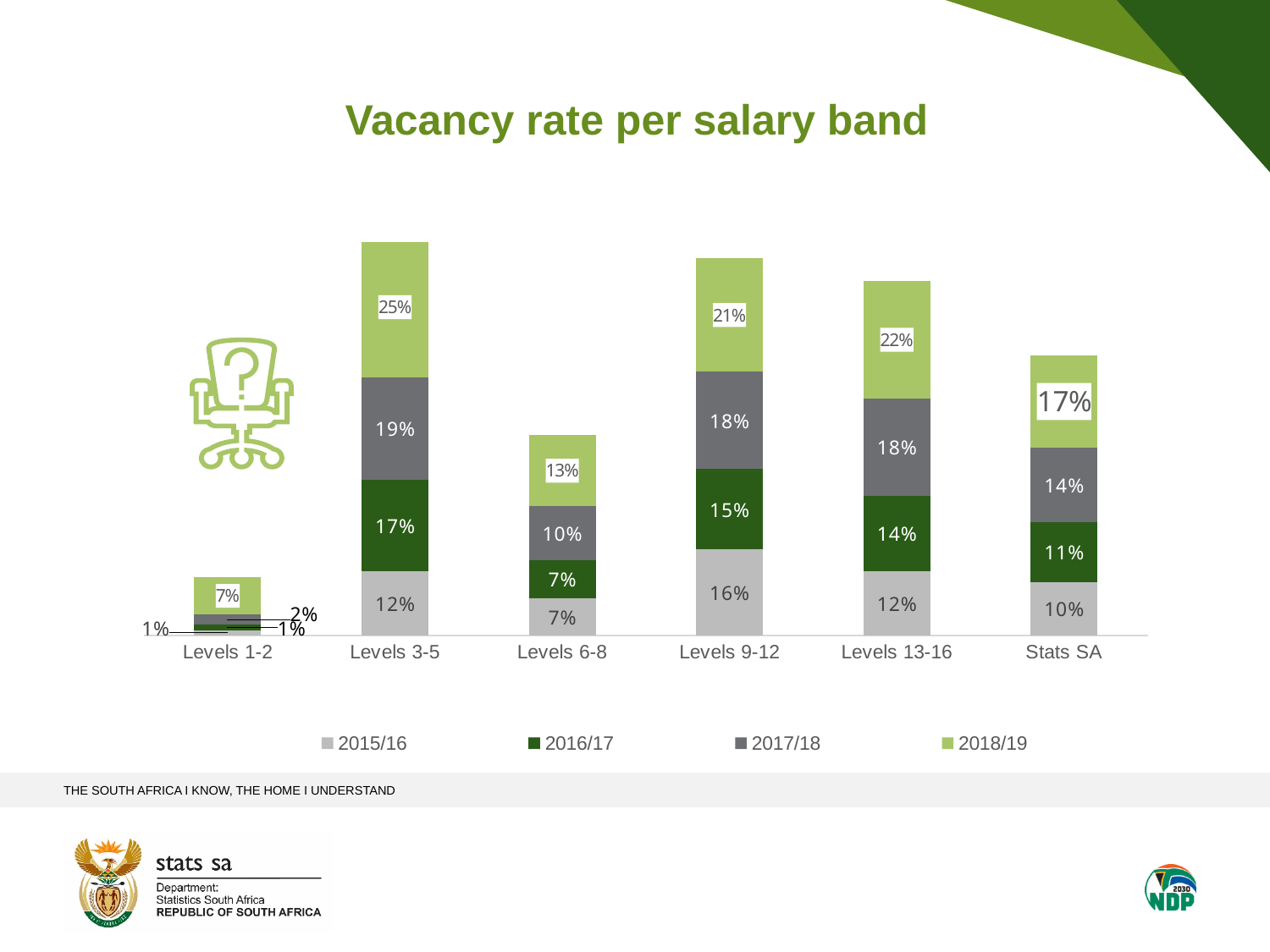
Which salary band has the highest vacancy rate in 2018/19? Levels 3-5 What is the total of the stacked bar for Levels 6-8? 37% What is the difference between the 2018/19 and 2015/16 vacancy rates for Levels 13-16? 10% What is the vacancy rate for Levels 9-12 in 2015/16? 16% What is the vacancy rate for Levels 6-8 in 2016/17? 7% What type of chart is shown on the slide? Stacked bar chart How many series does the legend list? 4 How many salary band categories are shown on the x axis? 6 Which is larger: the 2016/17 vacancy rate for Levels 9-12 or for Levels 13-16? Levels 9-12 What is the vacancy rate for Levels 3-5 in 2018/19? 25% Which salary band has the lowest vacancy rate in 2017/18? Levels 1-2 What is the vacancy rate for Stats SA in 2017/18? 14%